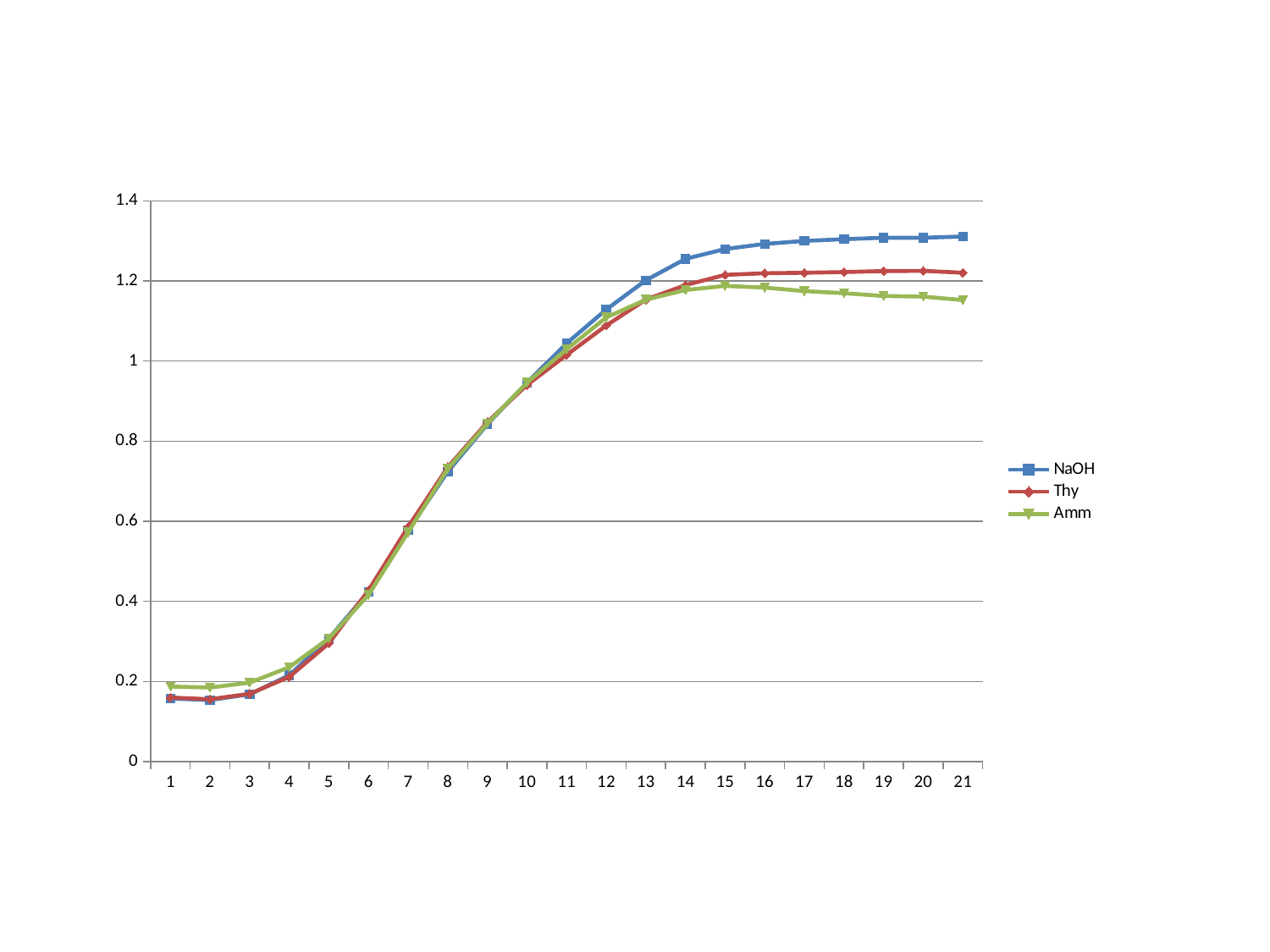
Is the value for Amm at x = 21 greater or less than 1.2? less At x = 21, which is larger, the value for Thy or the value for Amm? Thy Is the value for Thy at x = 8 greater or less than 0.6? greater Does the NaOH series generally rise or fall from x = 1 to x = 21? rise Which series has the lowest value at x = 21? Amm Which series has the highest value at x = 21? NaOH How many series does the legend list? 3 Is the value for NaOH at x = 1 greater or less than 0.2? less What kind of chart is shown on the slide? line chart How many points are plotted along the x axis for each series? 21 Which series is drawn in green? Amm